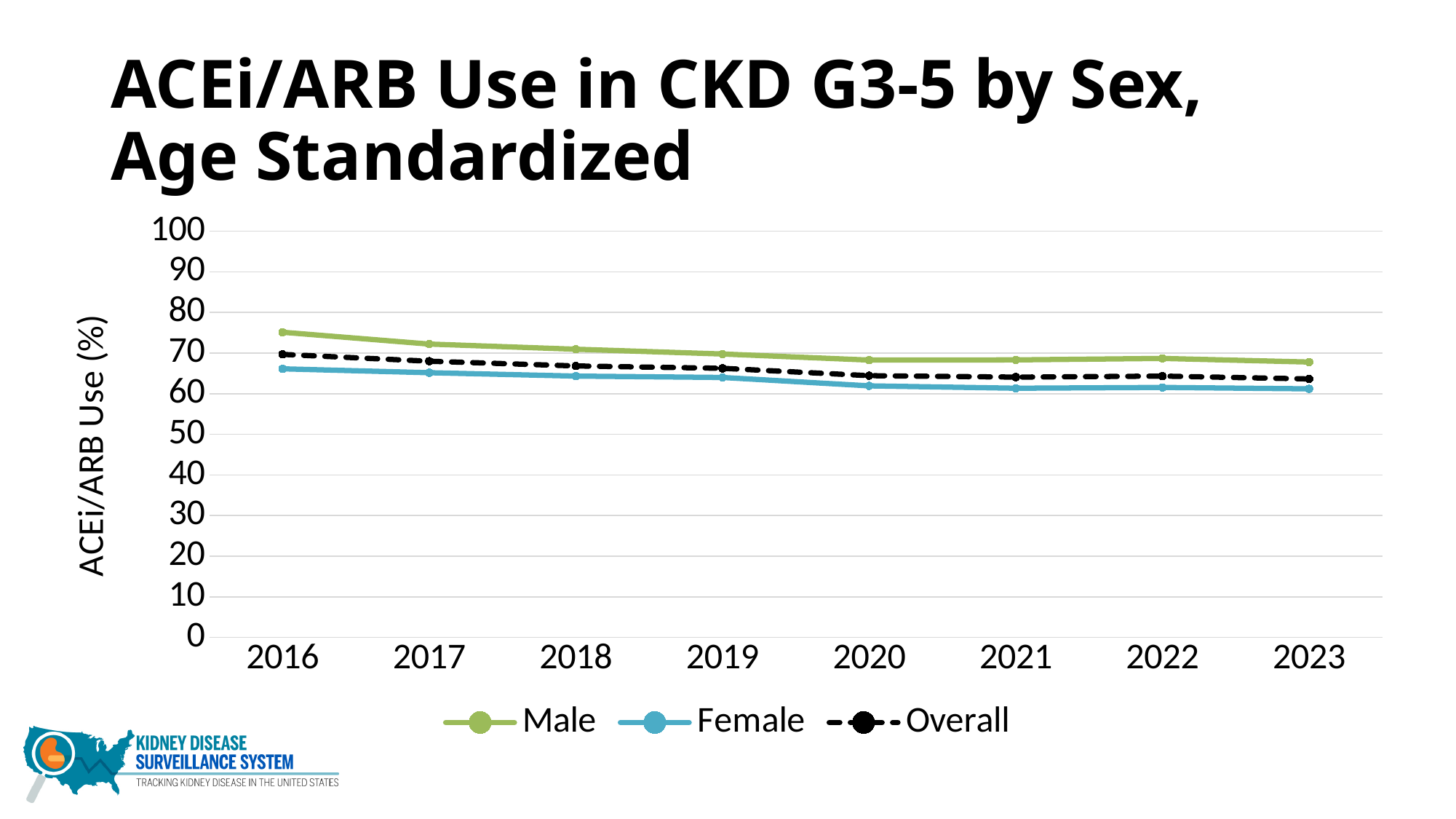
How many years are plotted along the x axis? 8 Does the Male series rise or fall from 2016 to 2023? fall How many series does the legend list? 3 Is the value for Male in 2016 greater or less than 70? greater Is the value for Overall in 2023 greater or less than 70? less Which series is drawn with a dashed line? Overall In which year is the Male series at its highest? 2016 Which series has the higher value in 2016, Male or Female? Male What kind of chart is shown on the slide? line chart Is the value for Male in 2016 greater or less than 80? less What is the label on the y axis? ACEi/ARB Use (%)